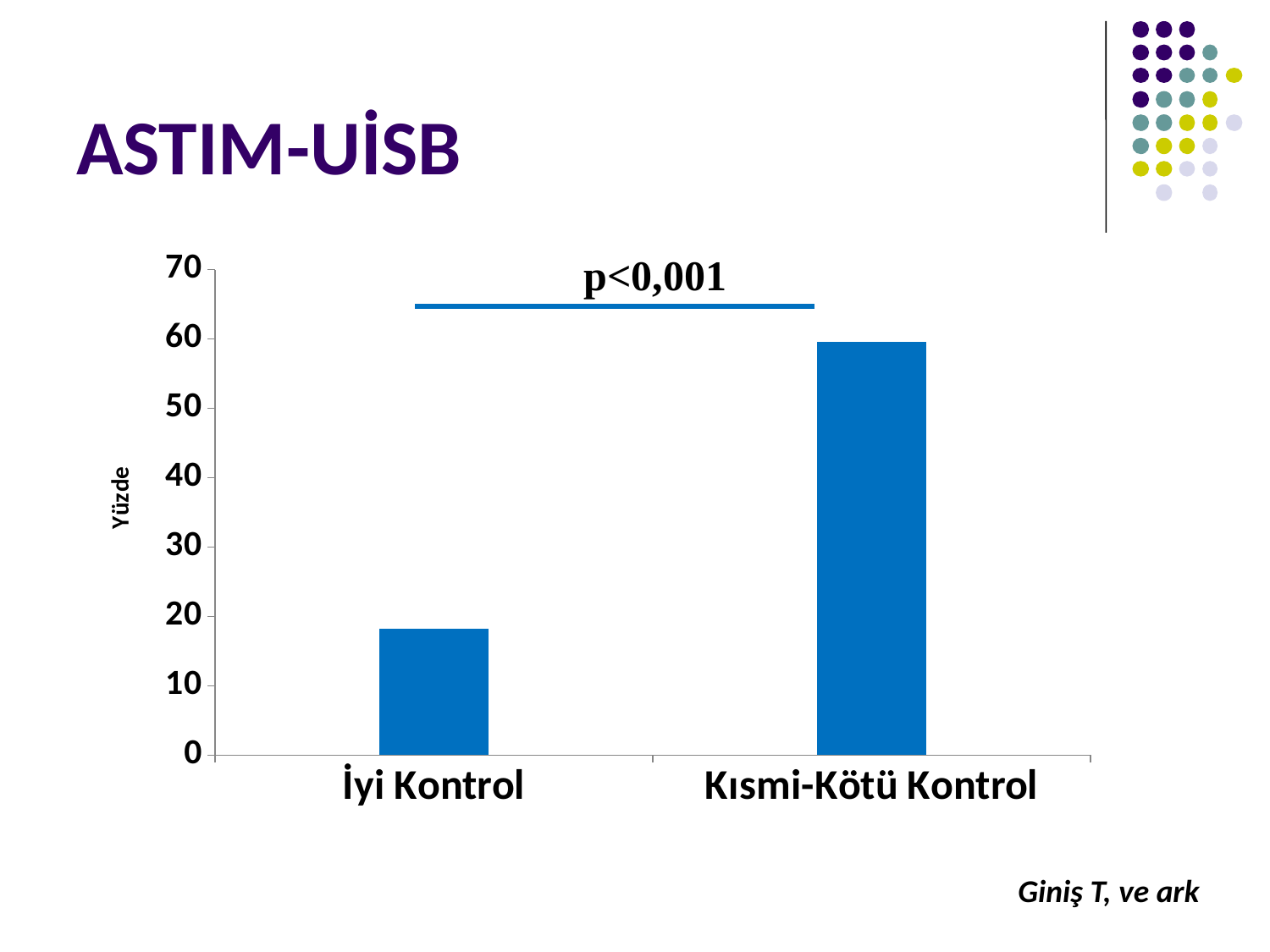
What is the label of the y axis of the chart? Yüzde Which is larger, the value for İyi Kontrol or the value for Kısmi-Kötü Kontrol? Kısmi-Kötü Kontrol How many categories are shown on the x axis of the chart? 2 Which category has the lowest bar in the chart? İyi Kontrol Is the value for İyi Kontrol greater or less than 20? less Is the value for Kısmi-Kötü Kontrol greater or less than 50? greater What kind of chart is shown on the slide? bar chart Which category has the highest bar in the chart? Kısmi-Kötü Kontrol What p-value annotation is shown above the bars in the chart? p<0,001 Is the value for İyi Kontrol greater or less than 10? greater